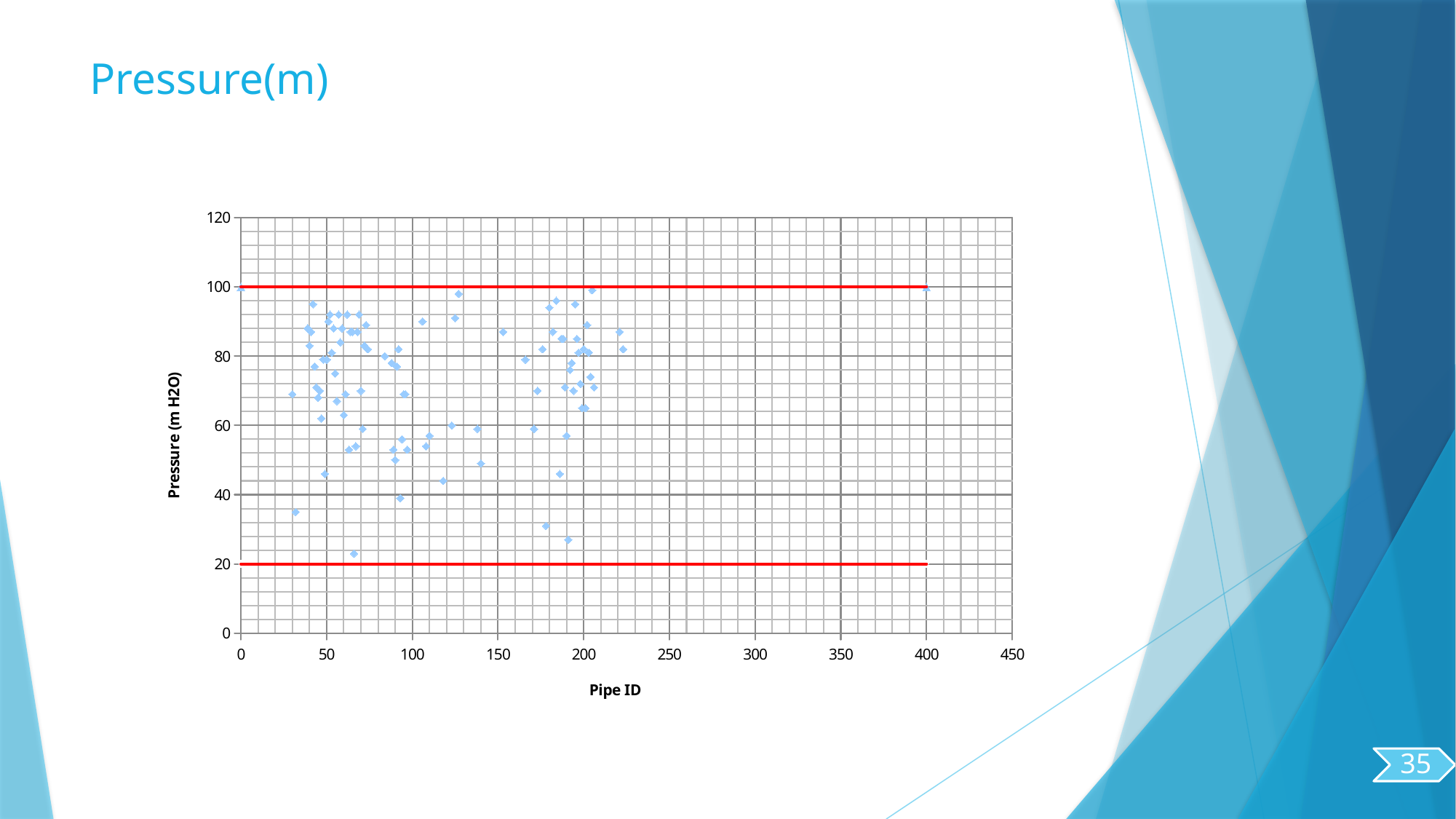
At what pressure value is the upper red horizontal line drawn? 100 Are there any plotted pressure points with a Pipe ID greater than 250? No What kind of chart is shown on the slide? Scatter chart Which of the two red lines is higher, the one at 100 or the one at 20? The one at 100 Do any of the plotted pressure points fall below the lower red line at 20? No Do any of the plotted pressure points fall above the upper red line at 100? No What is the label of the vertical axis? Pressure (m H2O) What is the highest value shown on the vertical axis? 120 What is the title of the chart on the slide? Pressure(m) At what pressure value is the lower red horizontal line drawn? 20 What is the highest value shown on the horizontal axis (Pipe ID)? 450